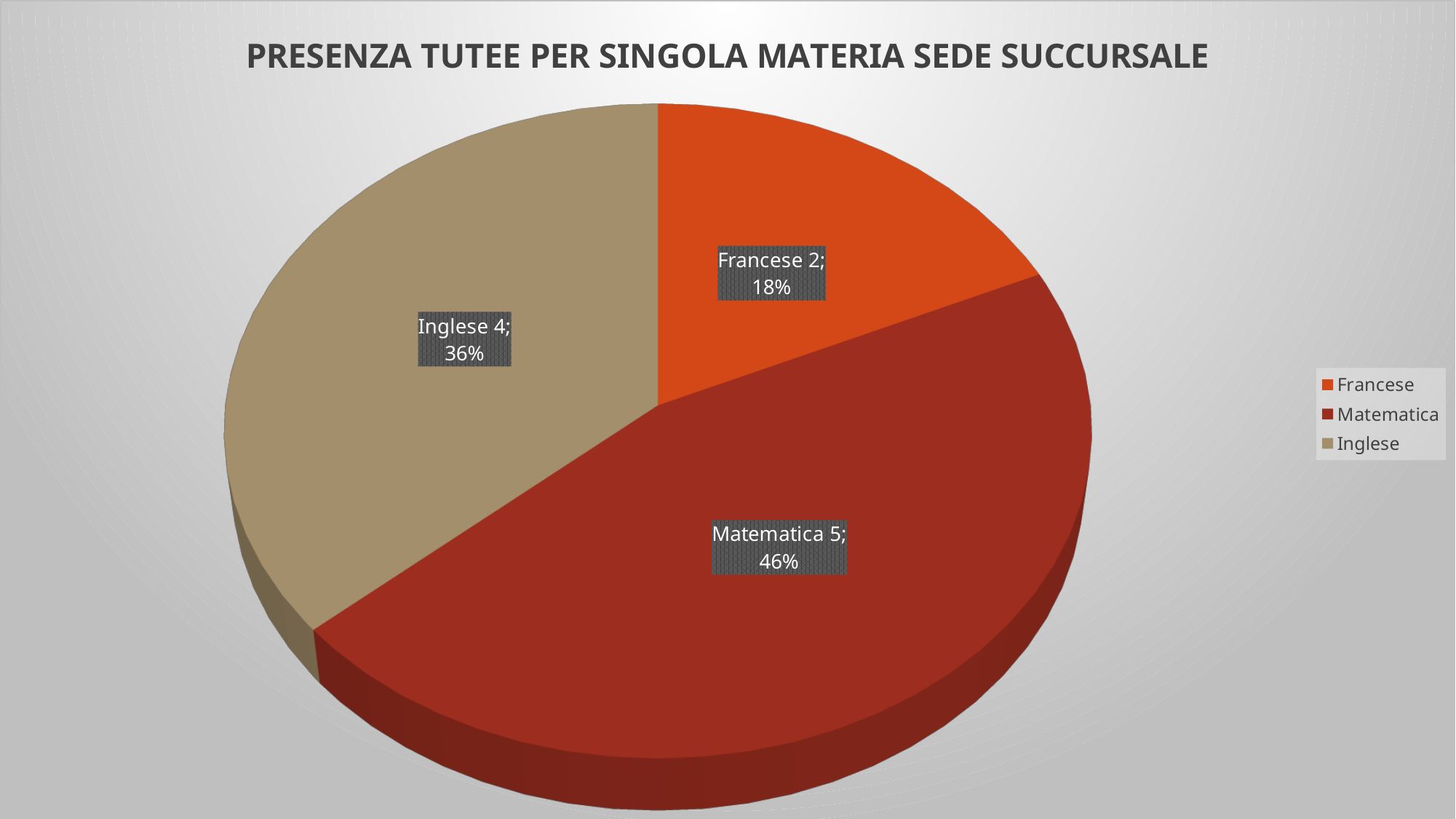
What percentage share does Inglese have? 36% How many slices does the pie chart have? 3 What is the value for Matematica? 5 What kind of chart is shown on the slide? Pie chart What is the difference between the values for Matematica and Francese? 3 Which is larger, the value for Inglese or the value for Francese? Inglese What percentage share does Matematica have? 46% What is the value for Francese? 2 What percentage share does Francese have? 18% Which subject has the smallest slice? Francese Which subject has the largest slice? Matematica What is the value for Inglese? 4